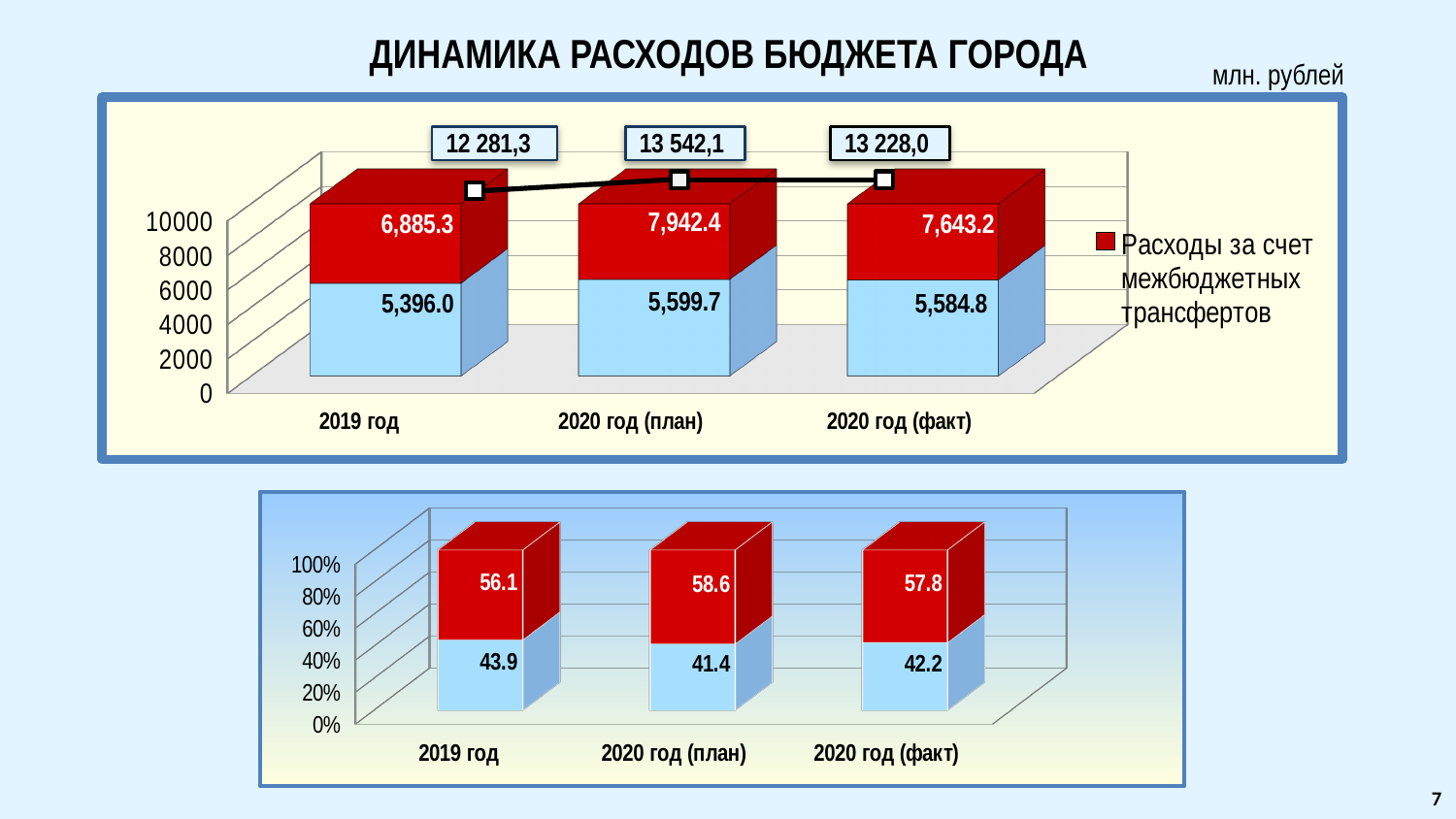
What is the legend entry shown in the top chart? Расходы за счет межбюджетных трансфертов In the top chart, which category has the highest total? 2020 год (план) How many categories are shown on the x axis of the top chart? 3 In the top chart, what is the difference between the red segment values for 2020 год (план) and 2020 год (факт)? 299.2 What kind of chart is the top chart? Stacked bar chart In the top chart, what total is shown above the bar for 2020 год (план)? 13 542,1 In the bottom chart, which category has the lowest light blue segment value? 2020 год (план) In the top chart, what is the value of the light blue segment for 2019 год? 5,396.0 In the top chart, what is the value of 'Расходы за счет межбюджетных трансфертов' (red segment) for 2019 год? 6,885.3 In the top chart, which has the larger light blue segment value: 2020 год (план) or 2020 год (факт)? 2020 год (план) In the bottom chart, what is the difference between the red and light blue segment values for 2019 год? 12.2 In the bottom chart, what is the red segment value for 2020 год (факт)? 57.8